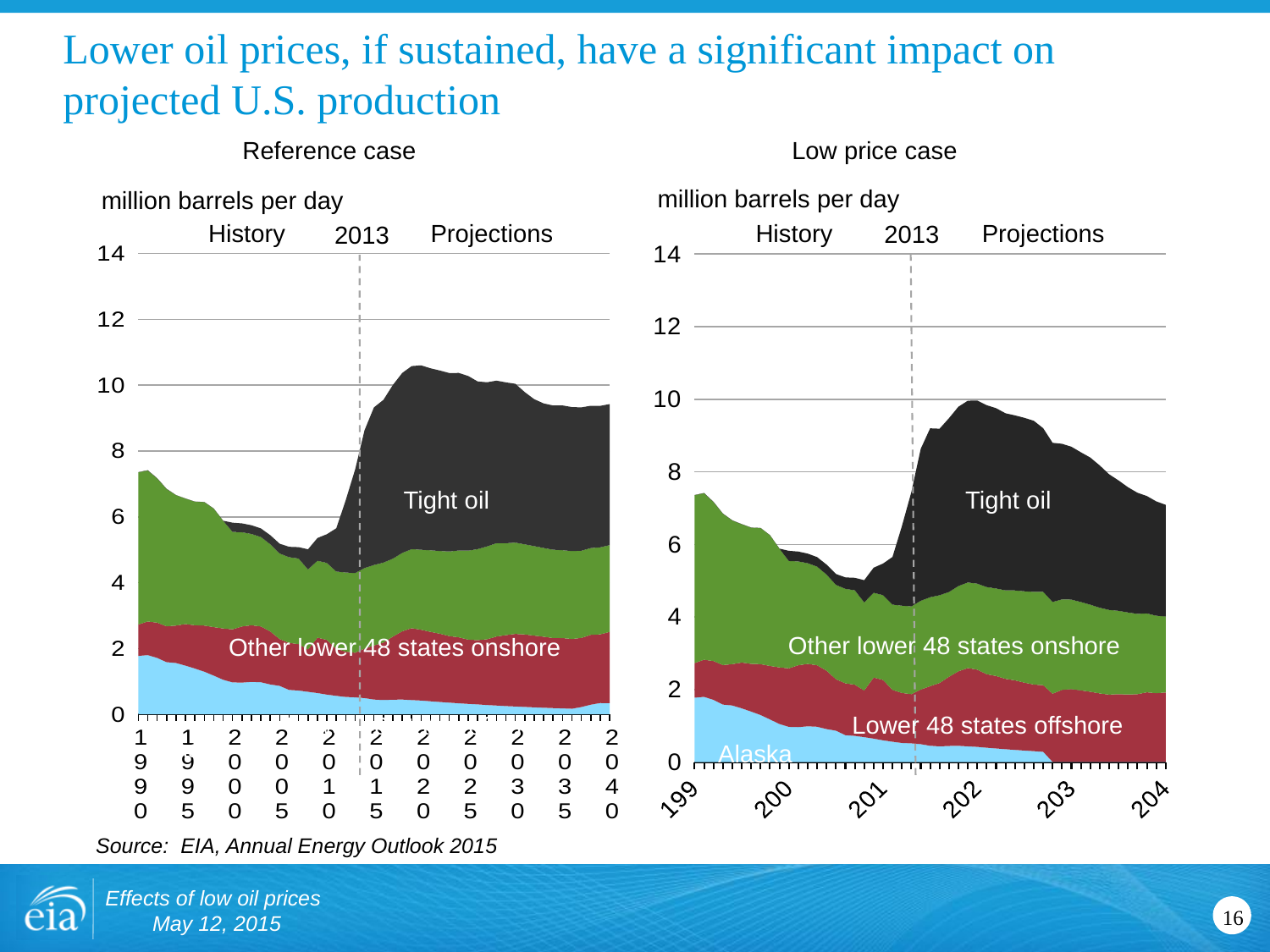
In the Low price case chart, is total production in 2040 greater or less than 8 million barrels per day? less In the Low price case chart, is total production in 2005 greater or less than 6 million barrels per day? less In the Reference case chart, is total production in 2040 greater or less than 8 million barrels per day? greater What unit is shown on the y axis of the Low price case chart? million barrels per day In the Low price case chart, does total production rise or fall between 2020 and 2040? fall Which chart shows higher total production in 2040, the Reference case or the Low price case? Reference case How many production categories are labelled in the Low price case chart? 4 In the Low price case chart, which year does the dashed vertical line mark as the boundary between History and Projections? 2013 In the Reference case chart, does total production rise or fall between 2010 and 2020? rise What type of chart is the Reference case chart? Stacked area chart